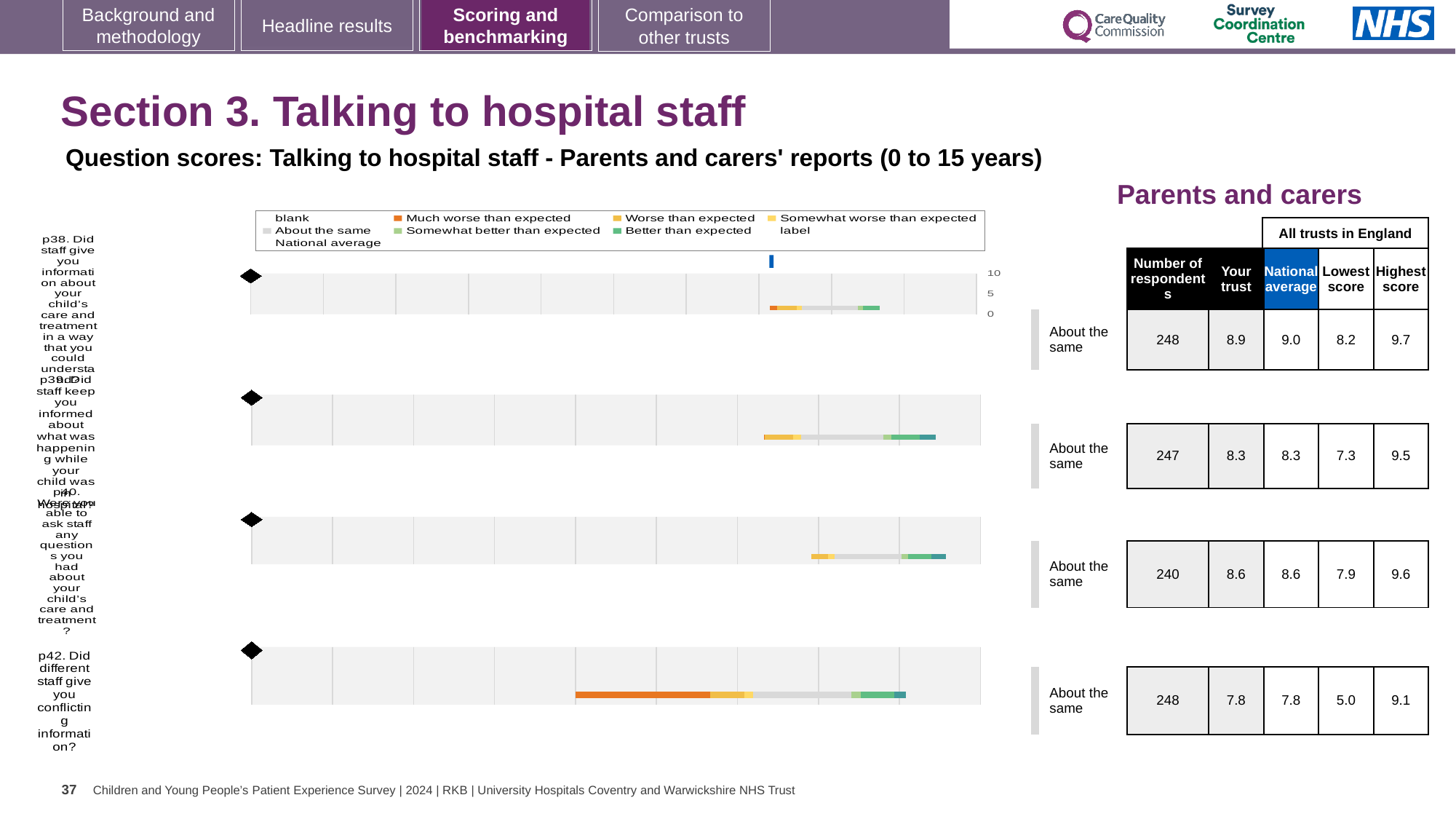
How many entries does the legend above the charts list? 9 In the table beside the charts, what is the 'Your trust' score for p39? 8.3 In the table beside the charts, what is the national average for p42? 7.8 In the table beside the charts, what is the number of respondents for p38? 248 What benchmark label is shown next to the chart for p38? About the same How many question charts are shown on the slide? 4 In the legend, what colour represents 'Much worse than expected'? orange In the table beside the charts, is the 'Your trust' score or the national average larger for p38? National average In the table beside the charts, which question has the lowest 'Lowest score' value? p42 What kind of chart is used to show the question scores on this slide? bar chart In the table beside the charts, what is the difference between the highest score and the lowest score for p40? 1.7 Which question's chart has the longest orange 'Much worse than expected' segment? p42. Did different staff give you conflicting information?